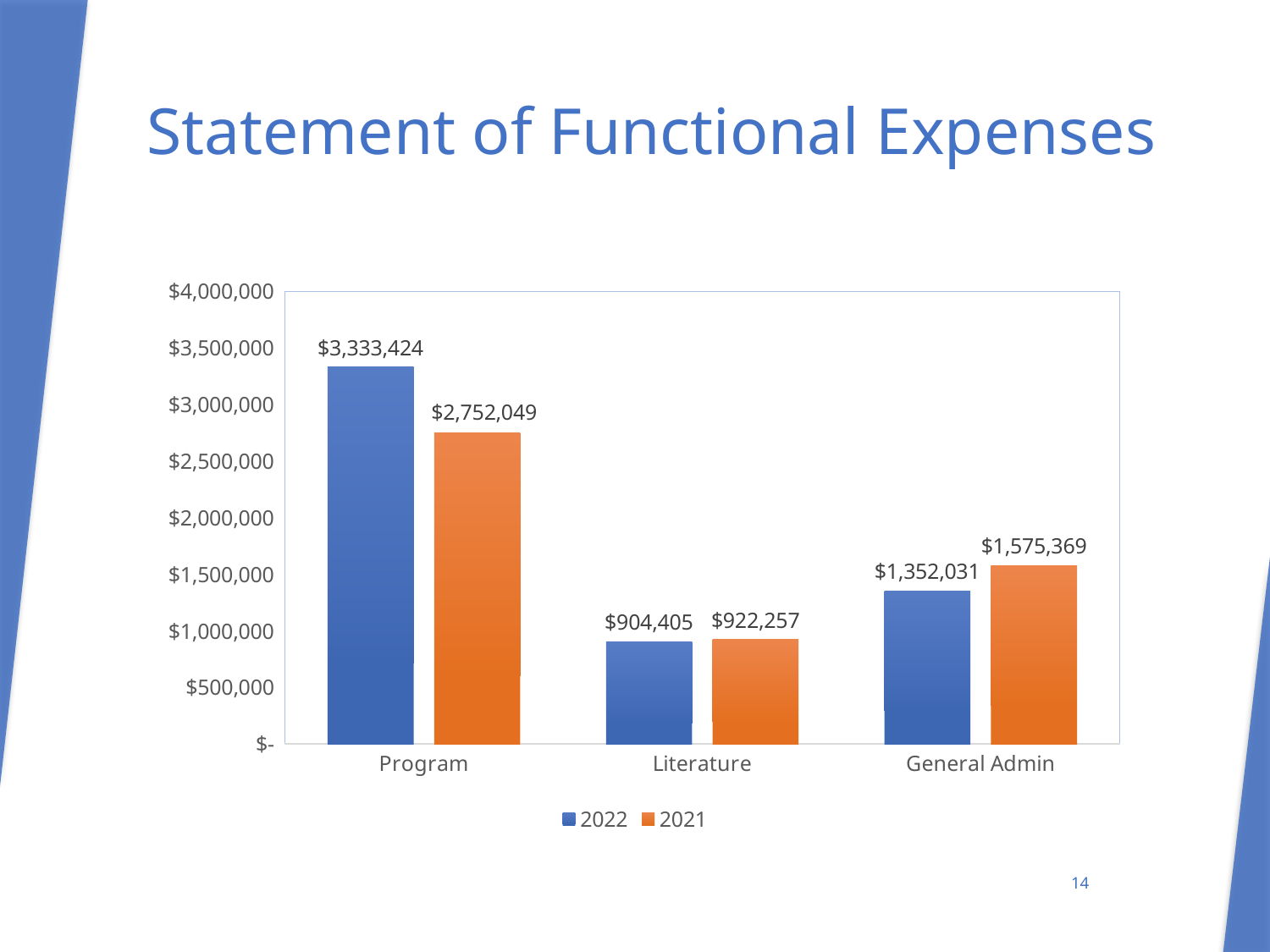
Which is larger for General Admin, the 2022 value or the 2021 value? 2021 What is the 2022 value for Program? $3,333,424 What is the difference between the 2022 and 2021 values for Program? $581,375 What is the 2022 value for Literature? $904,405 How many series does the legend list? 2 What is the 2021 value for General Admin? $1,575,369 Which category has the lowest 2021 value? Literature How many categories are shown on the x axis? 3 Is the 2021 value for Program greater or less than $3,000,000? less What is the difference between the 2021 and 2022 values for General Admin? $223,338 What kind of chart is shown on the slide? bar chart Which category has the highest 2022 value? Program